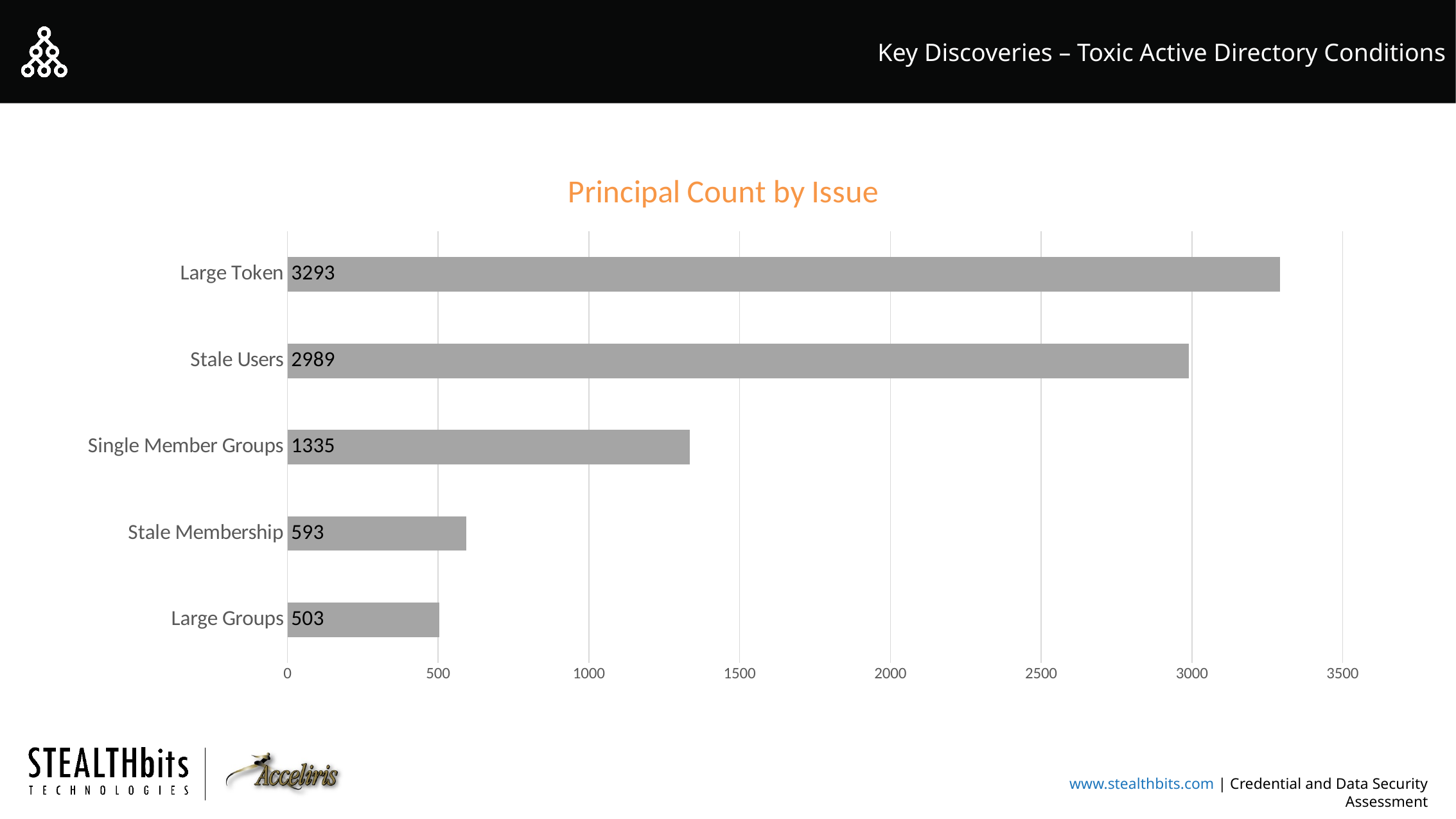
Which issue has the lowest principal count? Large Groups What kind of chart is shown on the slide? Bar chart What is the principal count for Stale Membership? 593 How many issues are shown in the chart? 5 What is the principal count for Stale Users? 2989 Which issue has the highest principal count? Large Token What is the title of the chart? Principal Count by Issue What is the difference between the principal counts for Large Token and Stale Users? 304 Which has a larger principal count, Stale Membership or Large Groups? Stale Membership What is the principal count for Large Token? 3293 What is the principal count for Single Member Groups? 1335 What is the principal count for Large Groups? 503